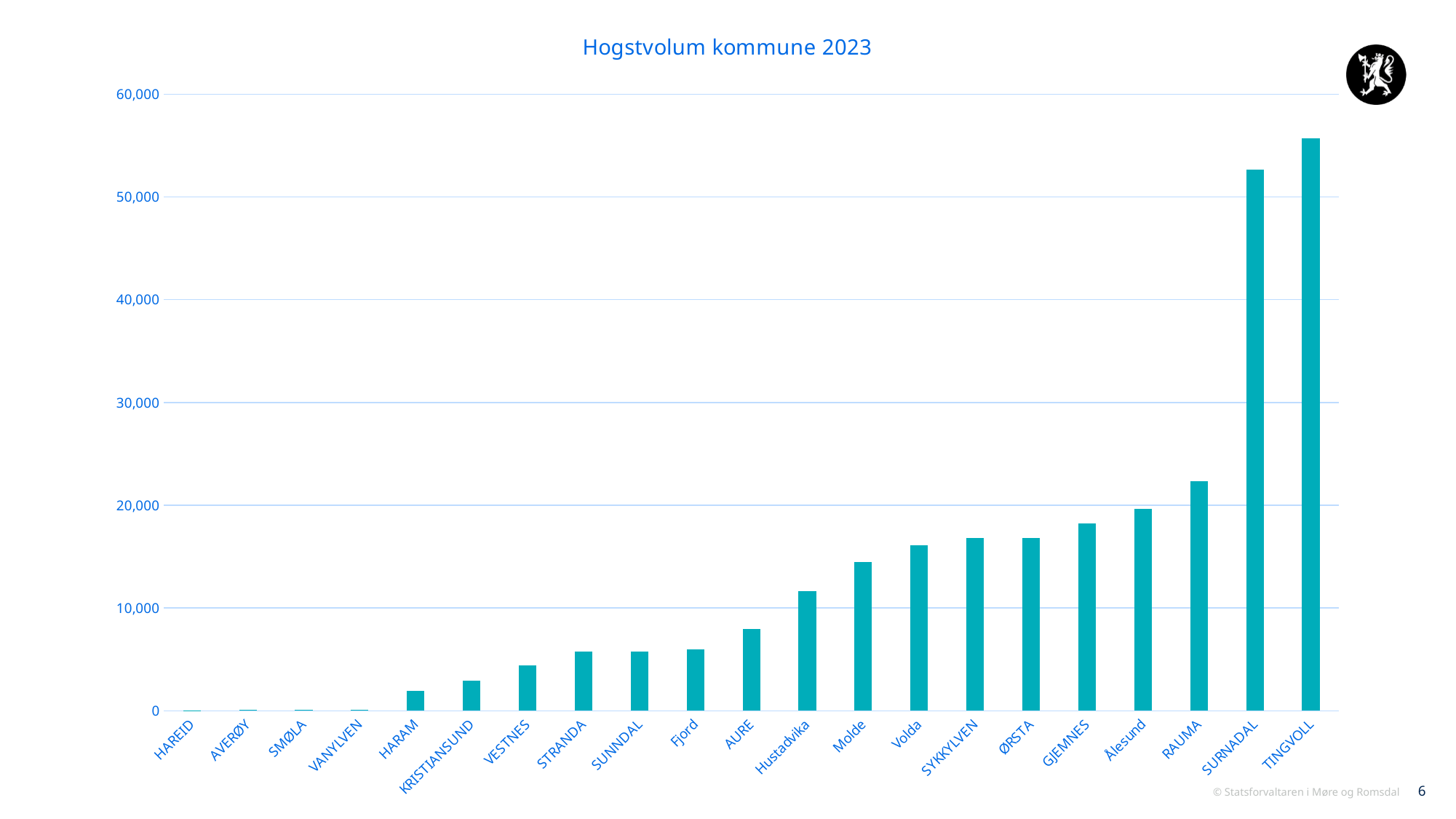
Is the value for Volda greater or less than 20,000? less What kind of chart is shown on the slide? bar chart What is the title of the chart? Hogstvolum kommune 2023 Which municipality has the highest value? TINGVOLL Is the value for AURE greater or less than 10,000? less Which has the larger value, SURNADAL or RAUMA? SURNADAL How many municipalities (categories) are shown on the x axis? 21 Is the value for Molde greater or less than 10,000? greater Which has the larger value, Hustadvika or AURE? Hustadvika Do the values generally rise or fall from left to right along the x axis? rise